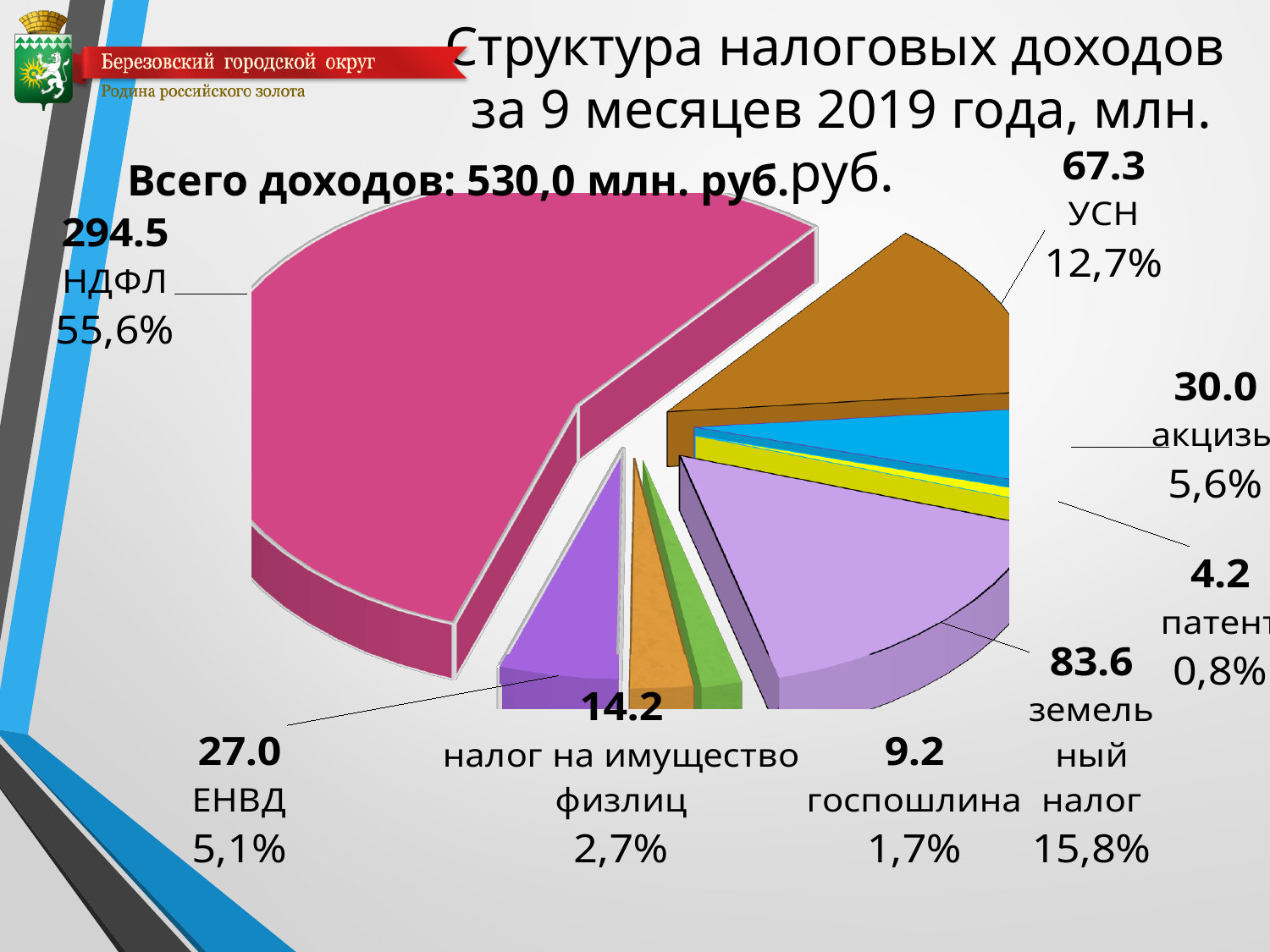
What total revenue amount is stated on the slide? 530,0 млн. руб. Which category has the smallest slice of the pie? патент What type of chart is shown on the slide? pie chart What share of the pie does патент represent? 0,8% What share of the pie does УСН represent? 12,7% Which is larger, the value for ЕНВД or the value for госпошлина? ЕНВД What is the difference between the values for УСН and акцизы? 37.3 What is the value shown for земельный налог? 83.6 Which category has the largest slice of the pie? НДФЛ What is the value shown for НДФЛ? 294.5 What share of the pie does налог на имущество физлиц represent? 2,7% How many slices does the pie chart have? 8